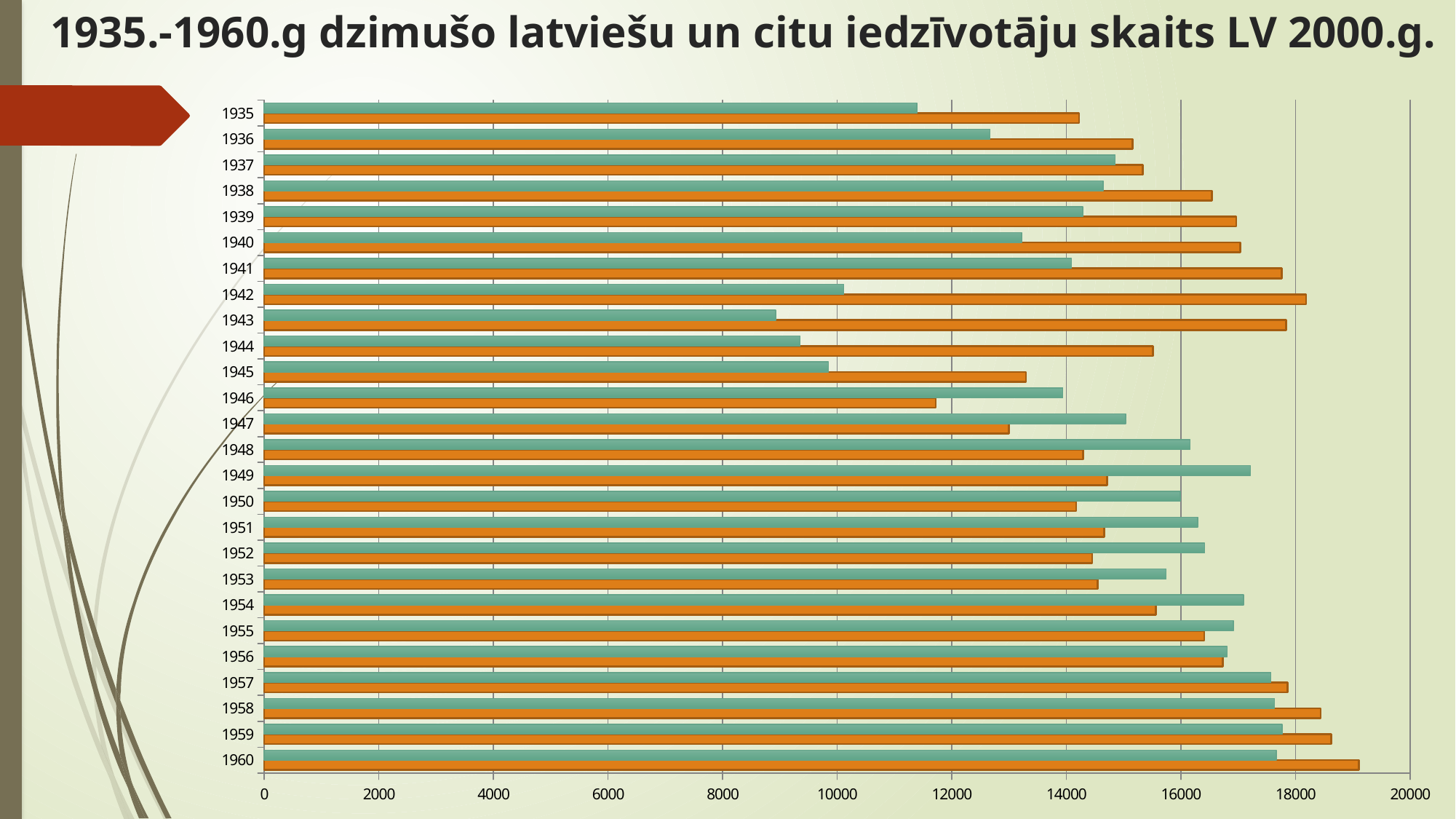
What kind of chart is shown on the slide? bar chart Is the value of the orange bar for 1945 greater or less than 12000? greater Is the value of the orange bar for 1960 greater or less than 18000? greater What is the highest value shown on the horizontal axis? 20000 Which year has the longest orange bar? 1960 How many bars are plotted for each year on the chart? 2 Is the value of the green bar for 1935 greater or less than 12000? less For 1943, which bar is longer, the green one or the orange one? orange For 1948, which bar is longer, the green one or the orange one? green How many years (categories) are shown on the chart? 26